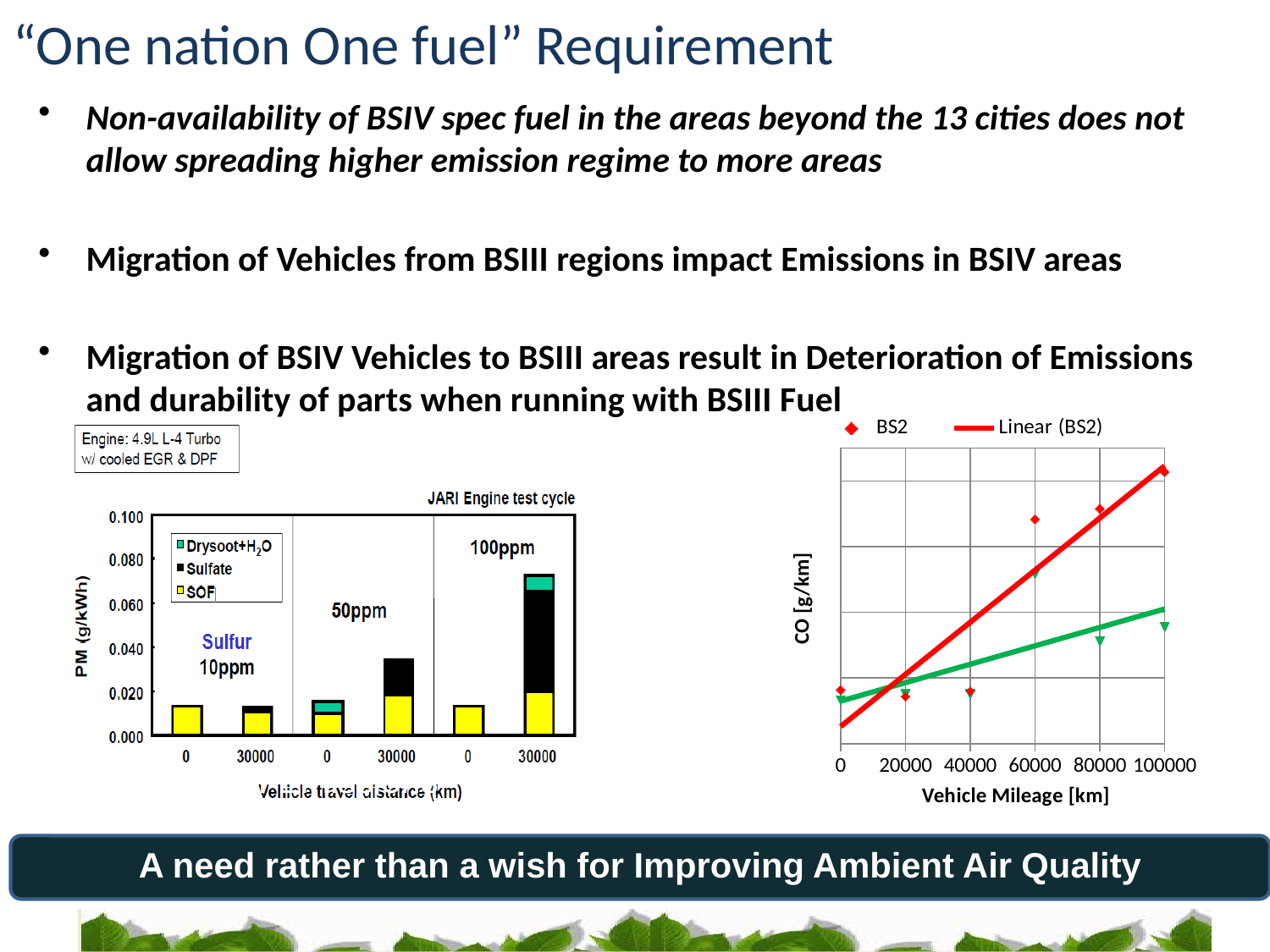
What kind of chart is the left chart showing PM against vehicle travel distance? bar chart In the left PM chart, which sulfur level has the highest total PM at 30000 km? 100ppm In the left PM chart, what is the label on the y axis? PM (g/kWh) In the left PM chart, is the total PM for 10ppm sulfur at 30000 km greater or less than 0.020? less What kind of chart is the right chart showing CO against vehicle mileage? scatter chart In the left PM chart, is the total PM for 50ppm sulfur at 30000 km greater or less than 0.040? less In the right CO chart, does the CO value for BS2 rise or fall as vehicle mileage increases? rise In the left PM chart, is the total PM for 100ppm sulfur at 30000 km greater or less than 0.060? greater In the left PM chart, which sulfur level has the lowest total PM at 30000 km? 10ppm In the right CO chart, what is the label on the x axis? Vehicle Mileage [km] In the right CO chart, what is the highest vehicle mileage tick shown on the x axis? 100000 In the left PM chart, how many series does the legend list? 3